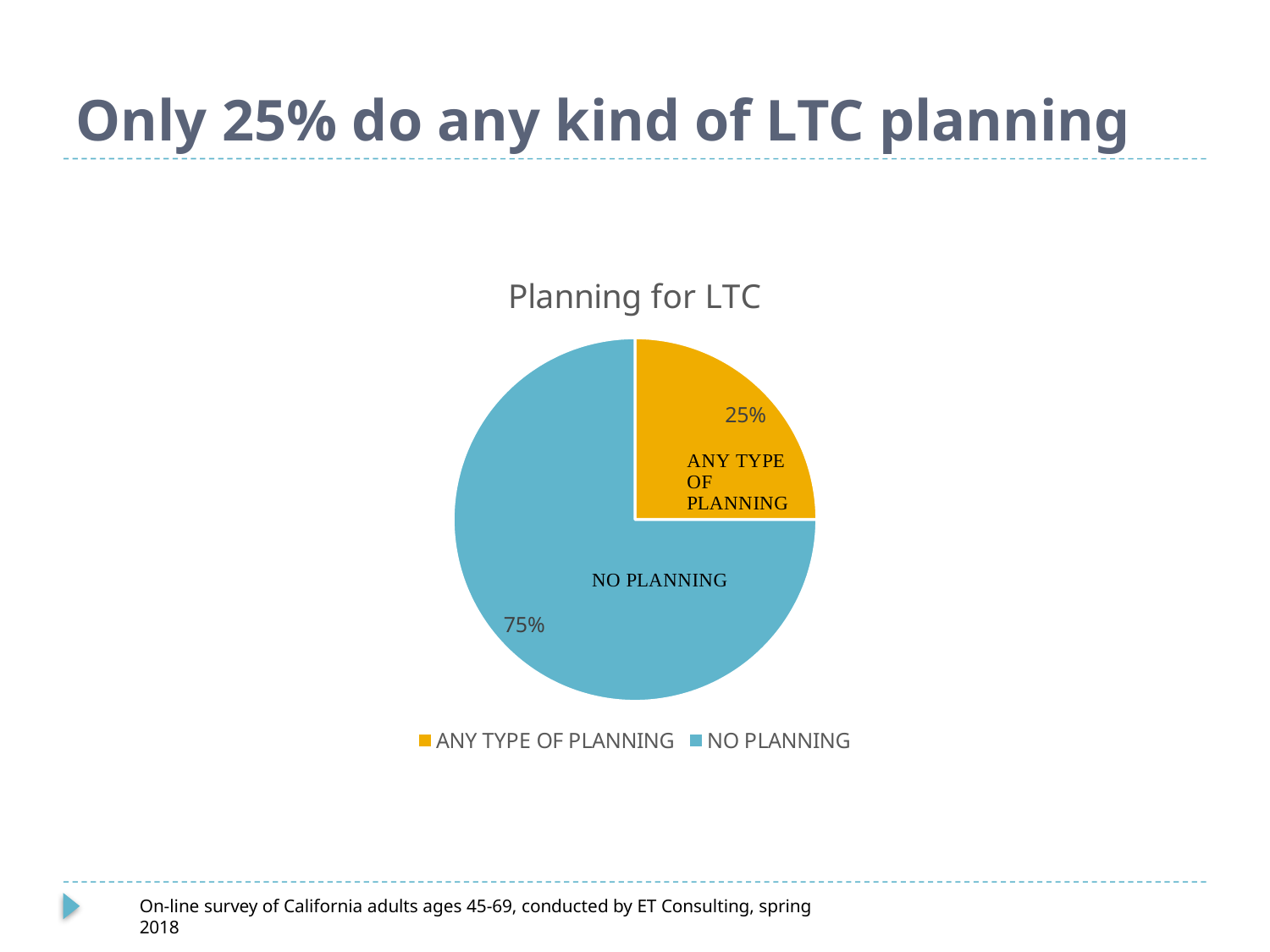
Which is larger, the ANY TYPE OF PLANNING slice or the NO PLANNING slice? NO PLANNING Which slice of the pie is the smallest? ANY TYPE OF PLANNING What colour is the NO PLANNING slice? Blue What is the total of the two slices shown in the pie chart? 100% What share of the pie is labelled NO PLANNING? 75% How many slices does the pie chart have? 2 What share of the pie is labelled ANY TYPE OF PLANNING? 25% Which slice of the pie is the largest? NO PLANNING What is the difference in percentage points between the NO PLANNING slice and the ANY TYPE OF PLANNING slice? 50 percentage points What type of chart is shown on the slide? Pie chart What is the title of the chart? Planning for LTC How many entries does the legend list? 2